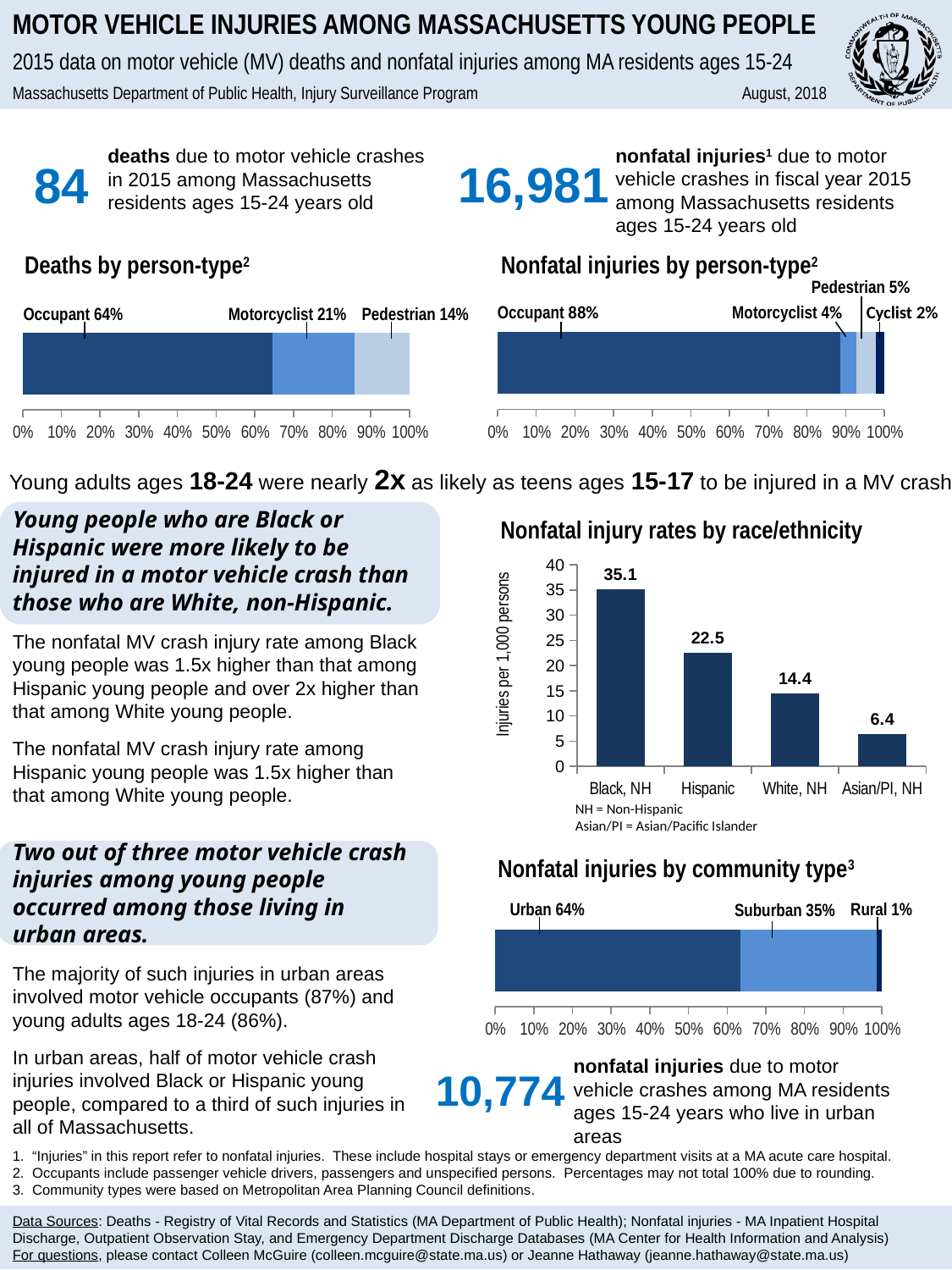
In the 'Nonfatal injuries by person-type' chart, what percentage of nonfatal injuries were pedestrians? 5% In the 'Deaths by person-type' chart, what percentage of deaths were motorcyclists? 21% In the 'Nonfatal injury rates by race/ethnicity' chart, what is the injury rate for Hispanic young people? 22.5 In the 'Nonfatal injuries by community type' chart, what is the difference between the Urban and Suburban percentages? 29% In the 'Nonfatal injuries by person-type' chart, which is larger: the share for Motorcyclist or the share for Cyclist? Motorcyclist In the 'Nonfatal injury rates by race/ethnicity' chart, which group has the highest injury rate? Black, NH In the 'Nonfatal injury rates by race/ethnicity' chart, do the values rise or fall from left to right? Fall What kind of chart is 'Nonfatal injury rates by race/ethnicity'? Bar chart In the 'Nonfatal injuries by community type' chart, what percentage of nonfatal injuries occurred among those living in suburban areas? 35% In the 'Nonfatal injury rates by race/ethnicity' chart, how many race/ethnicity groups are shown? 4 In the 'Nonfatal injury rates by race/ethnicity' chart, which group has the lowest injury rate? Asian/PI, NH In the 'Nonfatal injury rates by race/ethnicity' chart, what is the difference between the rates for Black, NH and White, NH? 20.7